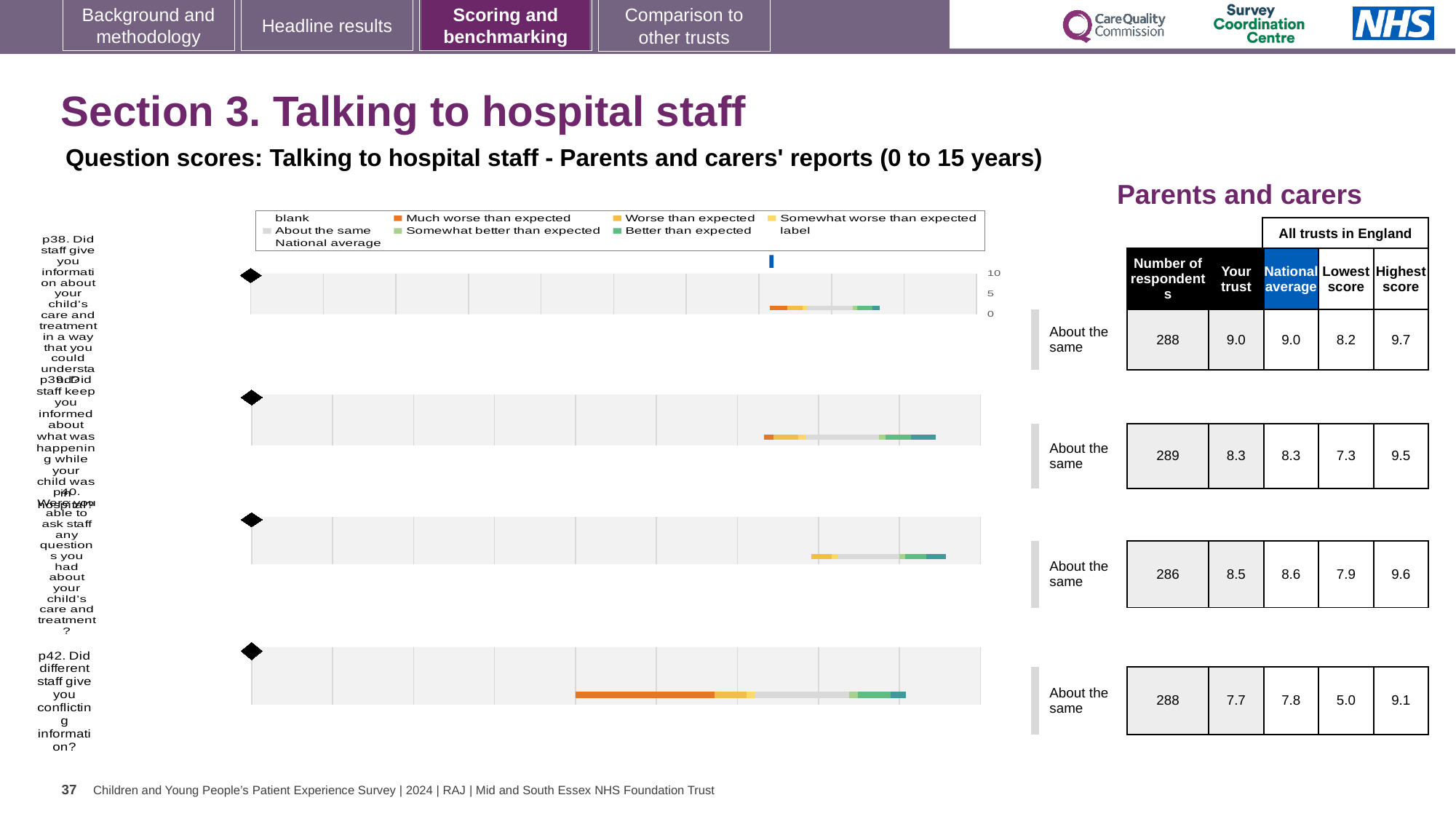
What kind of chart is used to show the question scores on this slide? Bar chart For p40, which is larger: the 'Your trust' score or the National average? National average What benchmarking category is shown next to each of the four charts? About the same Which question has the lowest 'Your trust' score? p42 Which question has the highest 'Your trust' score? p38 For p40 (Were you able to ask staff any questions you had about your child's care and treatment?), what is the National average score? 8.6 For p38, what is the Highest score among all trusts in England? 9.7 For p42 (Did different staff give you conflicting information?), what is the Lowest score among all trusts in England? 5.0 For p42, what is the difference between the Highest score and the Lowest score? 4.1 For p39 (Did staff keep you informed about what was happening while your child was in hospital?), what is the 'Your trust' score? 8.3 How many survey questions (p38 to p42) are plotted on the slide? 4 For p38 (Did staff give you information about your child's care and treatment in a way that you could understand?), what is the number of respondents? 288